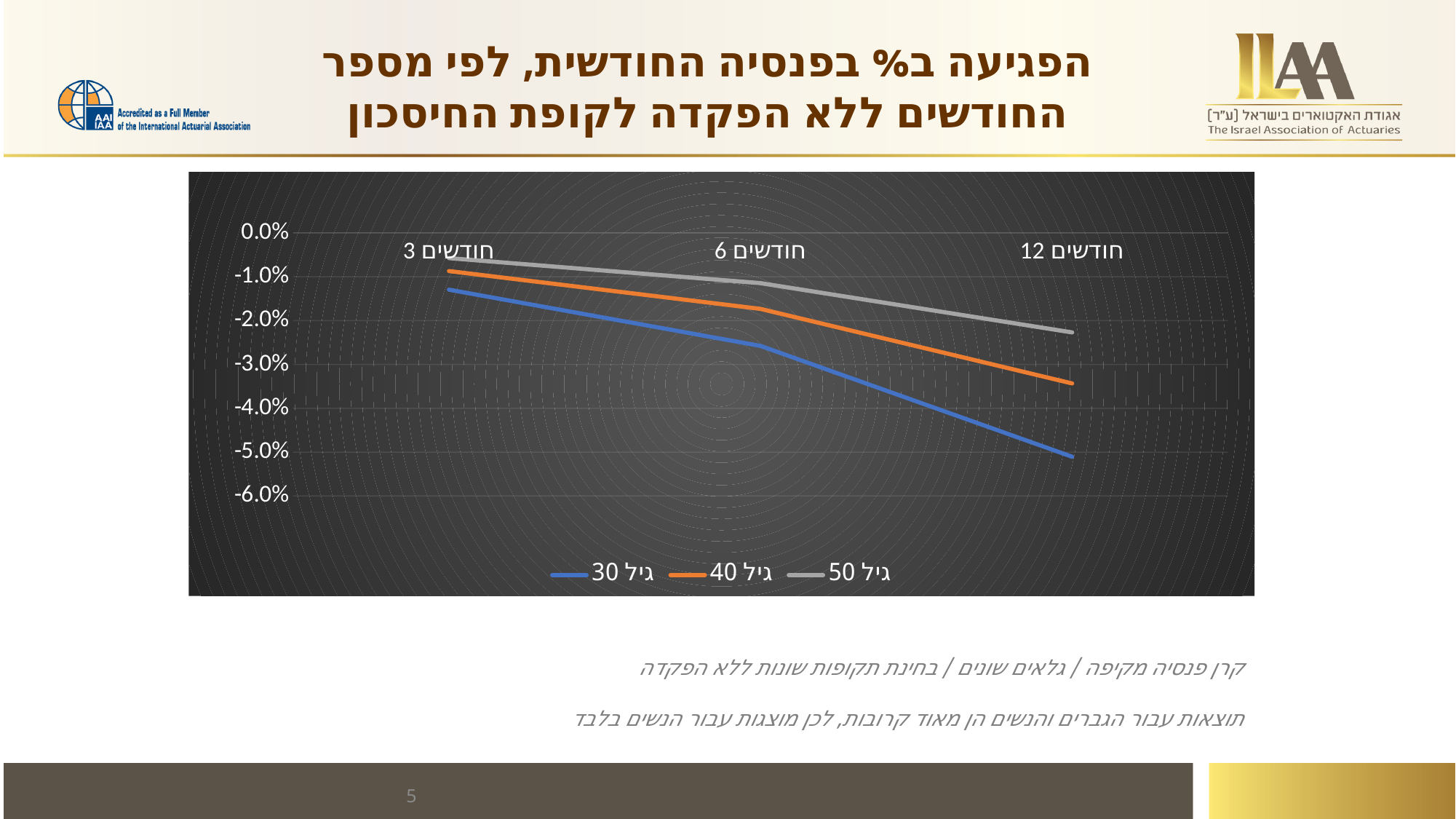
How many categories are shown on the x axis? 3 Which colour is used for the גיל 40 series? orange At 6 חודשים, which is larger: the value for גיל 40 or the value for גיל 30? גיל 40 How many series does the legend list? 3 Is the value for גיל 40 at 6 חודשים greater or less than -3.0%? greater Is the value for גיל 30 at 12 חודשים greater or less than -4.0%? less Is the value for גיל 50 at 3 חודשים greater or less than -1.0%? greater Which series has the highest value at 12 חודשים? גיל 50 Which series has the lowest value at 12 חודשים? גיל 30 Do the values for גיל 30 rise or fall from 3 חודשים to 12 חודשים? fall What kind of chart is shown on the slide? line chart